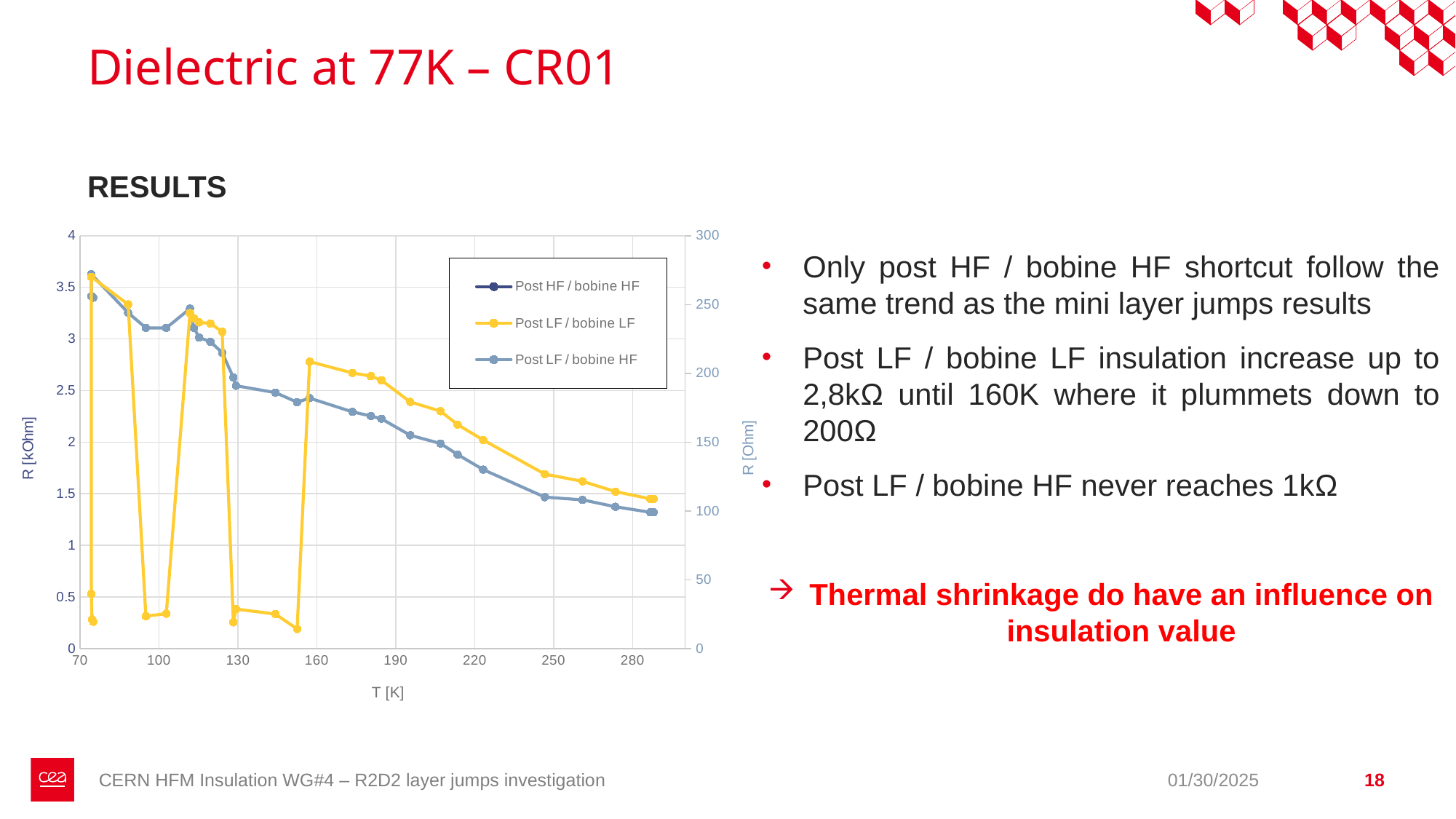
Is the value of the Post LF / bobine LF series at around 160 K greater or less than 2.5 on the left axis? greater Is the value of the Post LF / bobine LF series at its last point (around 290 K) greater or less than 2 on the left axis? less What is the maximum value shown on the right y axis (R [Ohm]) of the chart? 300 What is the label of the left y axis of the chart? R [kOhm] Does the Post LF / bobine HF series rise or fall as temperature increases along the x axis? Fall What kind of chart is shown on the slide? Line chart How many series does the chart legend list? 3 What is the maximum value shown on the left y axis (R [kOhm]) of the chart? 4 What is the lowest temperature tick shown on the x axis of the chart? 70 What is the label of the x axis of the chart? T [K] Which series is drawn in yellow in the chart? Post LF / bobine LF